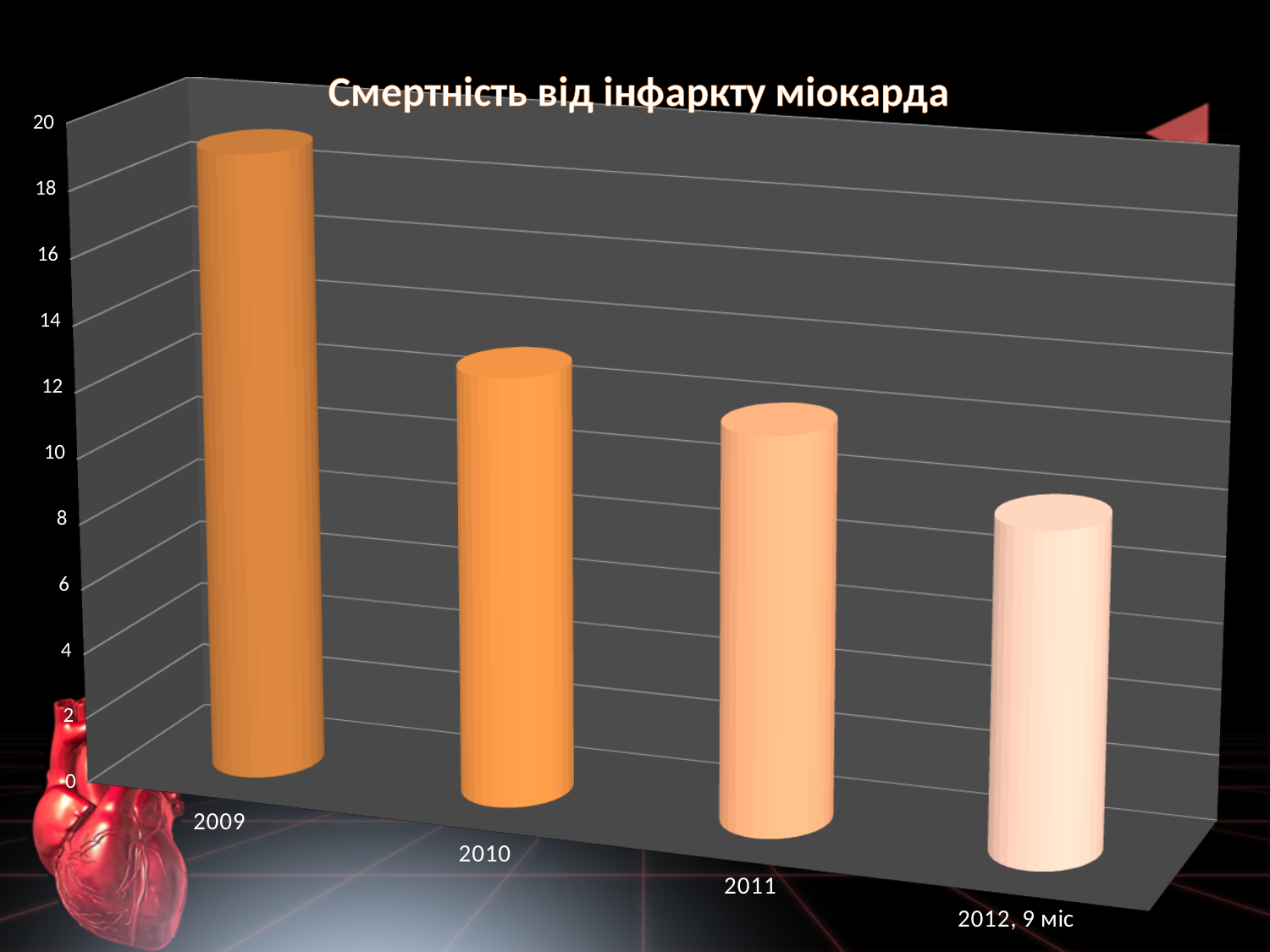
Do the values rise or fall from 2009 to 2012, 9 міс? fall Which is larger, the value for 2009 or the value for 2012, 9 міс? 2009 Is the value for 2009 greater or less than 16? greater Which category has the lowest value? 2012, 9 міс Which is larger, the value for 2010 or the value for 2011? 2010 What is the title of the chart? Смертність від інфаркту міокарда What kind of chart is shown on the slide? bar chart Is the value for 2011 greater or less than 14? less How many categories are plotted on the x axis? 4 Which category has the highest value? 2009 Is the value for 2010 greater or less than 10? greater